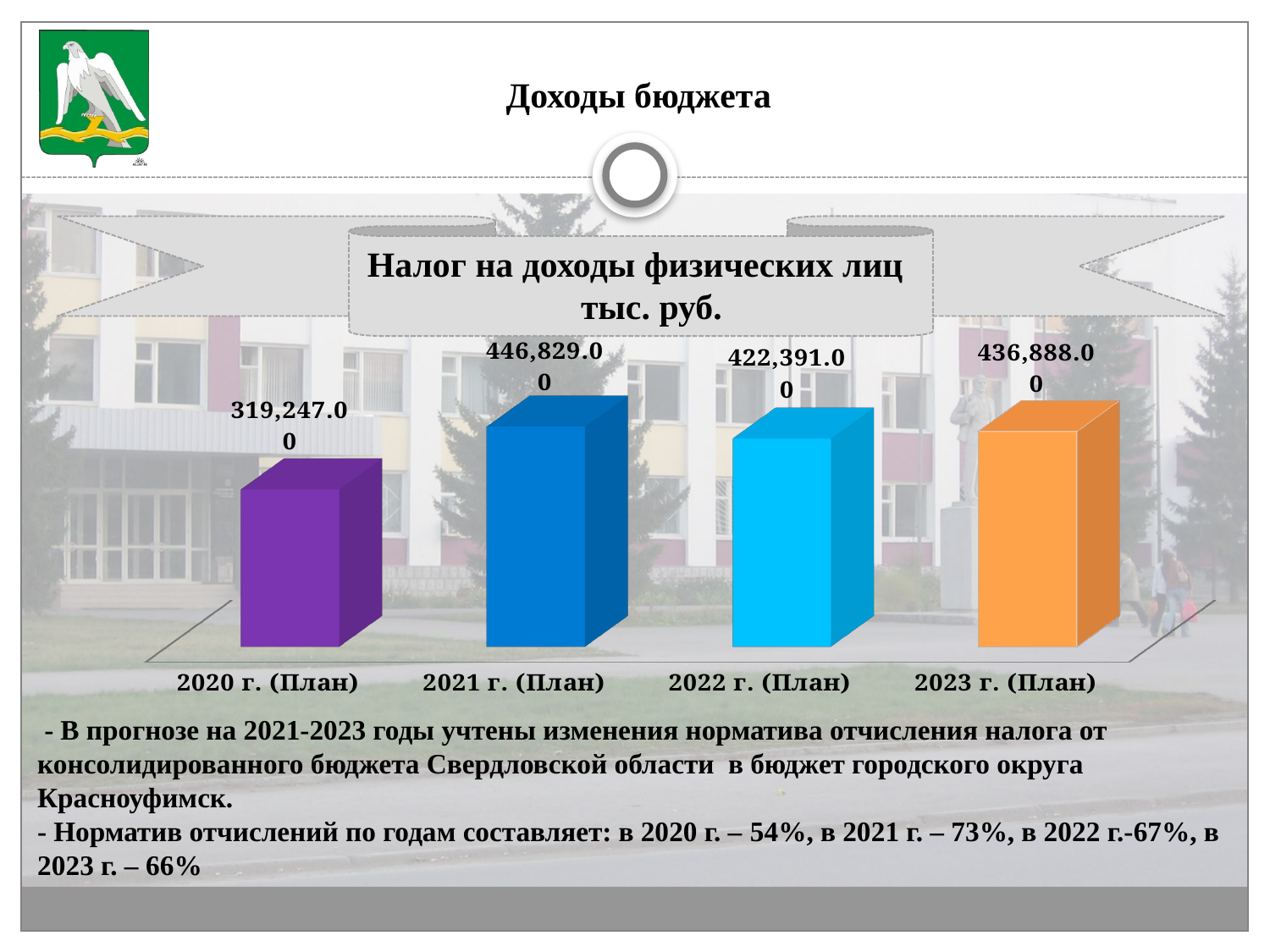
What is the value for 2020 г. (План)? 319,247.00 What is the difference between the values for 2021 г. (План) and 2020 г. (План)? 127,582.00 What is the value for 2022 г. (План)? 422,391.00 What is the value for 2021 г. (План)? 446,829.00 What is the difference between the values for 2023 г. (План) and 2022 г. (План)? 14,497.00 How many years are shown on the chart? 4 What is the value for 2023 г. (План)? 436,888.00 Which year has the lowest value? 2020 г. (План) What kind of chart is shown? bar chart Which is larger, the value for 2022 г. (План) or 2023 г. (План)? 2023 г. (План) Does the value rise or fall from 2021 г. (План) to 2022 г. (План)? fall Which year has the highest value? 2021 г. (План)